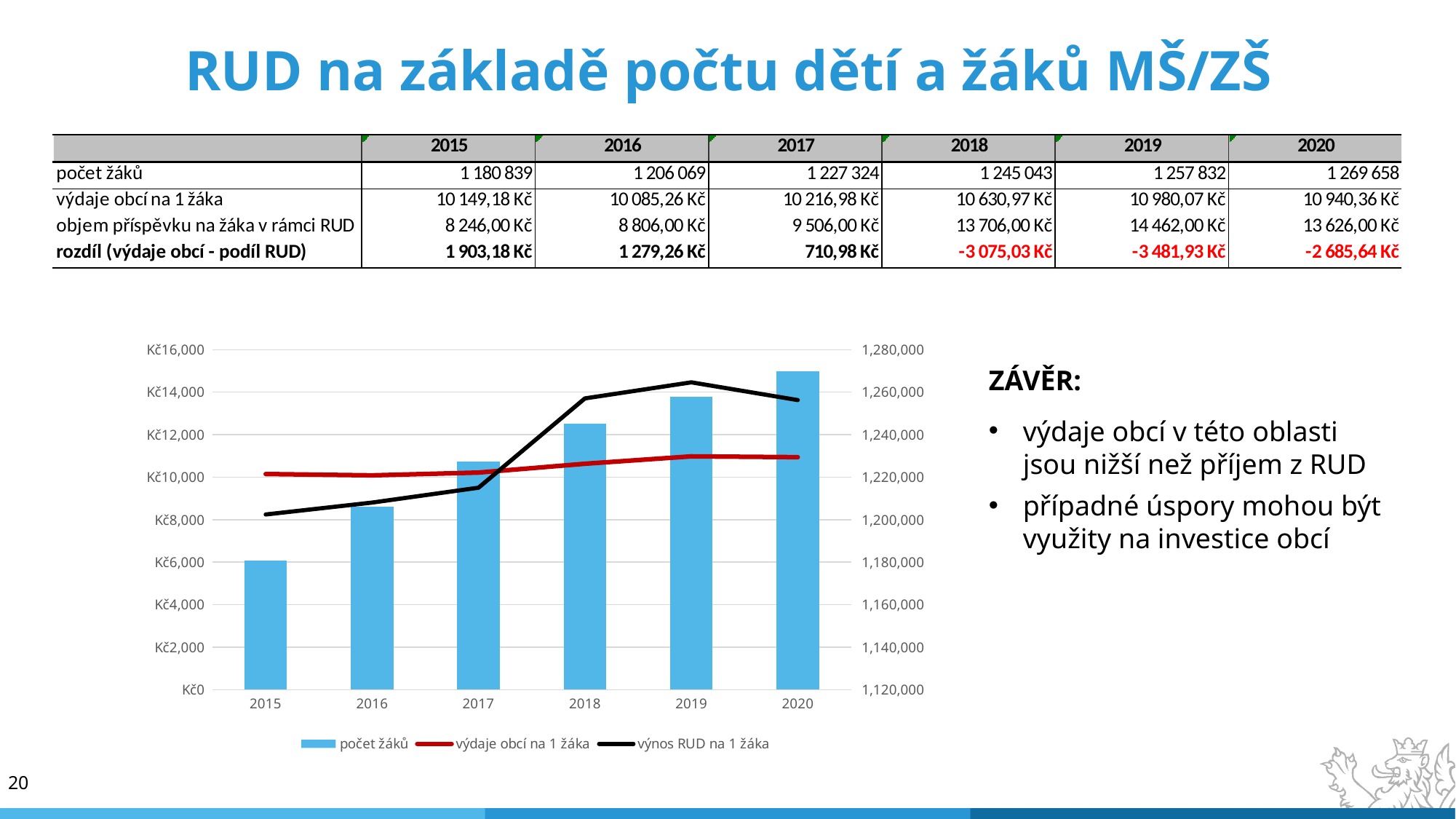
Is the value of výnos RUD na 1 žáka in 2019 greater or less than Kč14,000? greater In 2016, which line is higher: výdaje obcí na 1 žáka or výnos RUD na 1 žáka? výdaje obcí na 1 žáka What kind of chart is shown on the slide? A combined bar and line chart In 2018, which line is higher: výdaje obcí na 1 žáka or výnos RUD na 1 žáka? výnos RUD na 1 žáka In which year is the bar for počet žáků the highest? 2020 How many years are shown on the x axis of the chart? 6 How many series does the chart legend list? 3 In which year does the výnos RUD na 1 žáka line reach its highest point? 2019 Is the value of výnos RUD na 1 žáka in 2015 greater or less than Kč10,000? less Do the bars for počet žáků rise or fall from 2015 to 2020? Rise What colour is the line for výnos RUD na 1 žáka in the chart? Black In which year is the bar for počet žáků the lowest? 2015